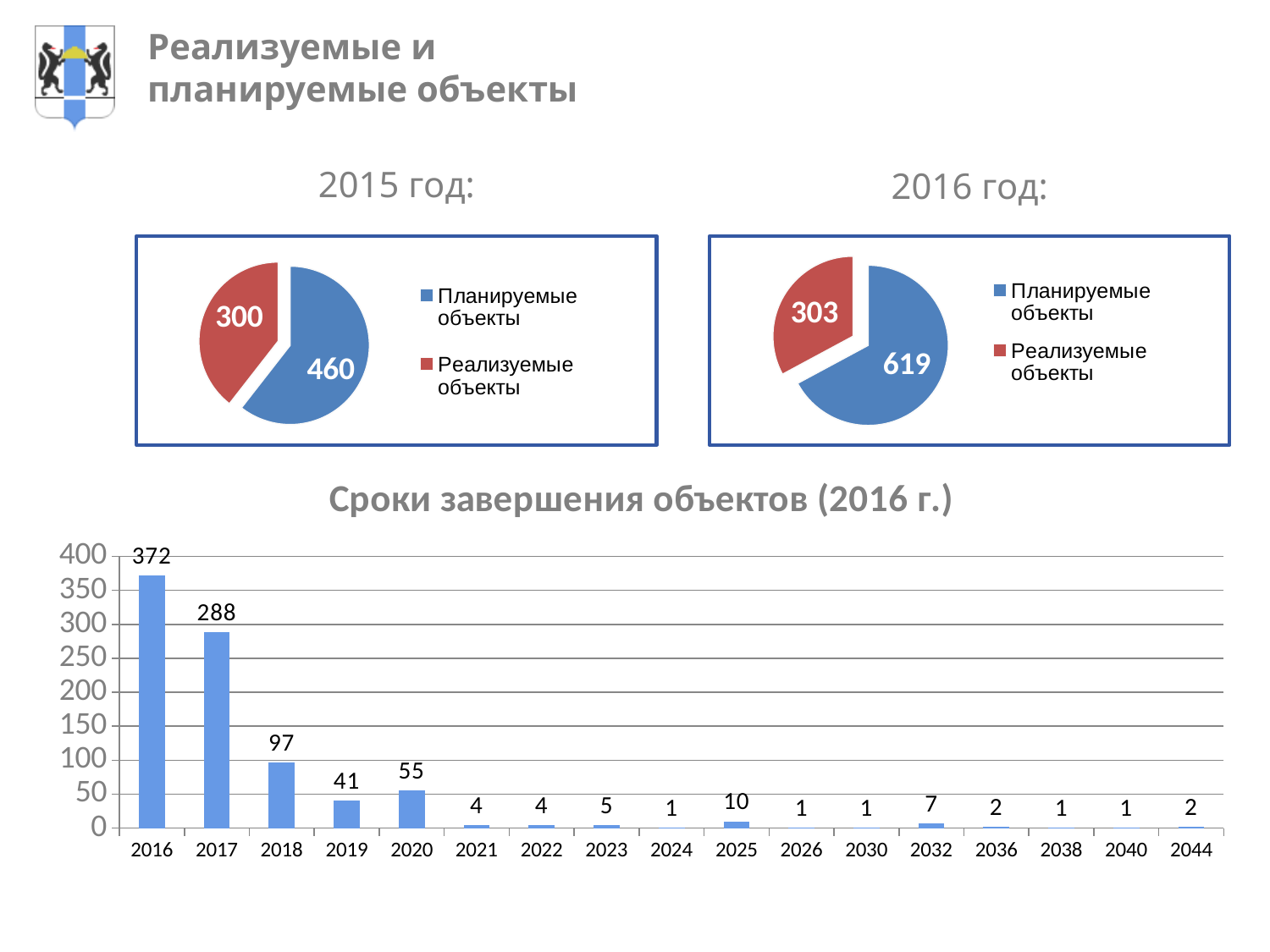
In the 2015 год pie chart, what is the value for Реализуемые объекты? 300 In the chart 'Сроки завершения объектов (2016 г.)', how many years are shown on the x axis? 17 In the chart 'Сроки завершения объектов (2016 г.)', which is larger, the value for 2019 or the value for 2020? 2020 In the chart 'Сроки завершения объектов (2016 г.)', what is the value for 2018? 97 In the chart 'Сроки завершения объектов (2016 г.)', which year has the highest value? 2016 In the 2015 год pie chart, what is the total of the two slices? 760 In the 2016 год pie chart, which slice is larger, Планируемые объекты or Реализуемые объекты? Планируемые объекты In the 2016 год pie chart, what is the difference between Планируемые объекты and Реализуемые объекты? 316 In the chart 'Сроки завершения объектов (2016 г.)', what is the difference between the values for 2016 and 2017? 84 In the 2016 год pie chart, what is the value for Планируемые объекты? 619 In the 2015 год pie chart, what is the value for Планируемые объекты? 460 What kind of chart is 'Сроки завершения объектов (2016 г.)'? Bar chart